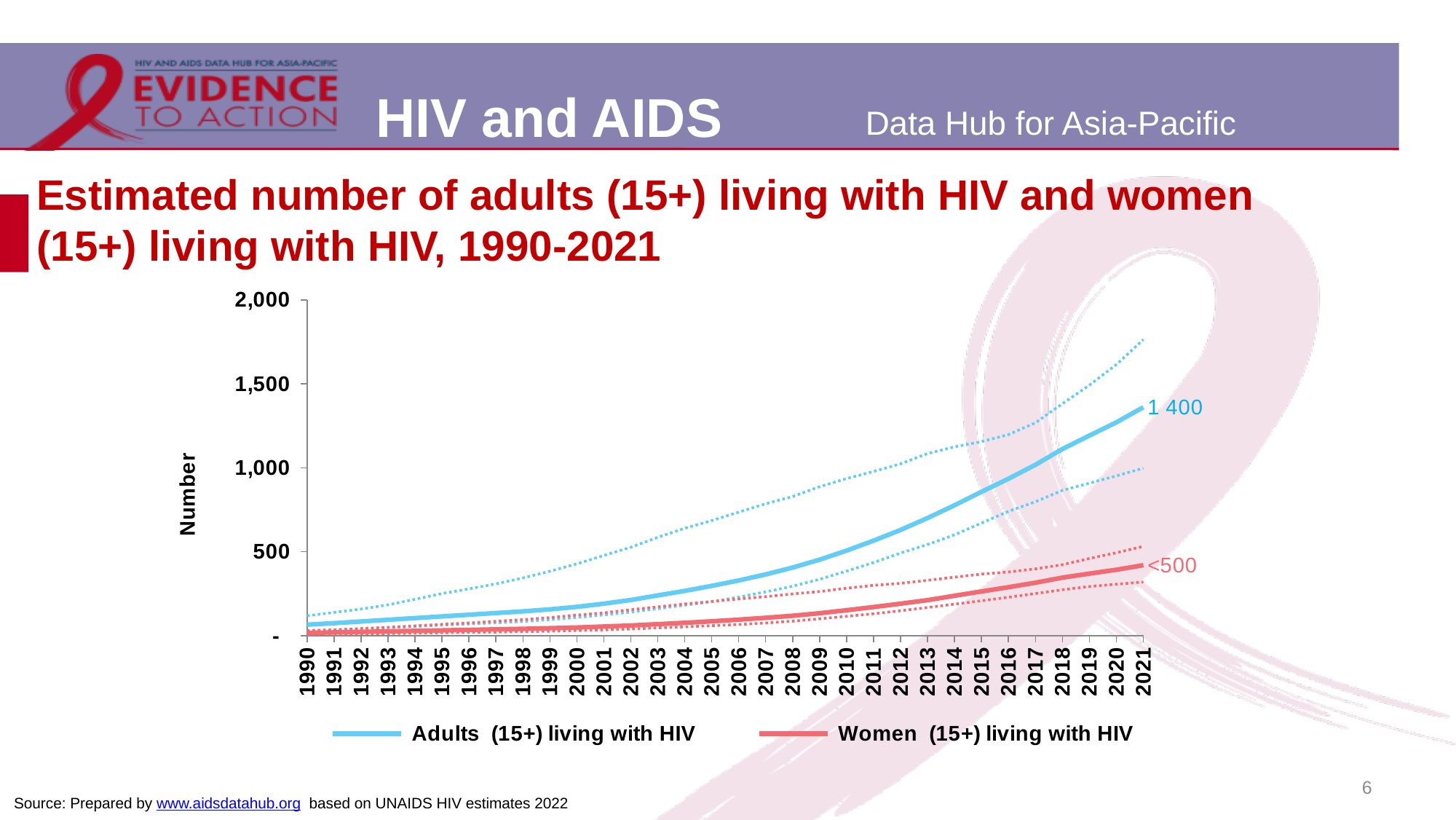
In 2021, which series has the larger value: Adults (15+) living with HIV or Women (15+) living with HIV? Adults (15+) living with HIV How many series does the legend list? 2 Is the value for Adults (15+) living with HIV in 2021 greater or less than 1,000? greater In which year is the value for Adults (15+) living with HIV highest? 2021 What is the title of the vertical axis? Number Is the value for Adults (15+) living with HIV in 2010 greater or less than 1,000? less Is the value for Adults (15+) living with HIV in 2000 greater or less than 500? less How many years are shown on the x axis? 32 What kind of chart is shown on the slide? Line chart Do the values for Adults (15+) living with HIV rise or fall from 1990 to 2021? Rise What is the labelled value for Women (15+) living with HIV in 2021? <500 What is the labelled value for Adults (15+) living with HIV in 2021? 1 400